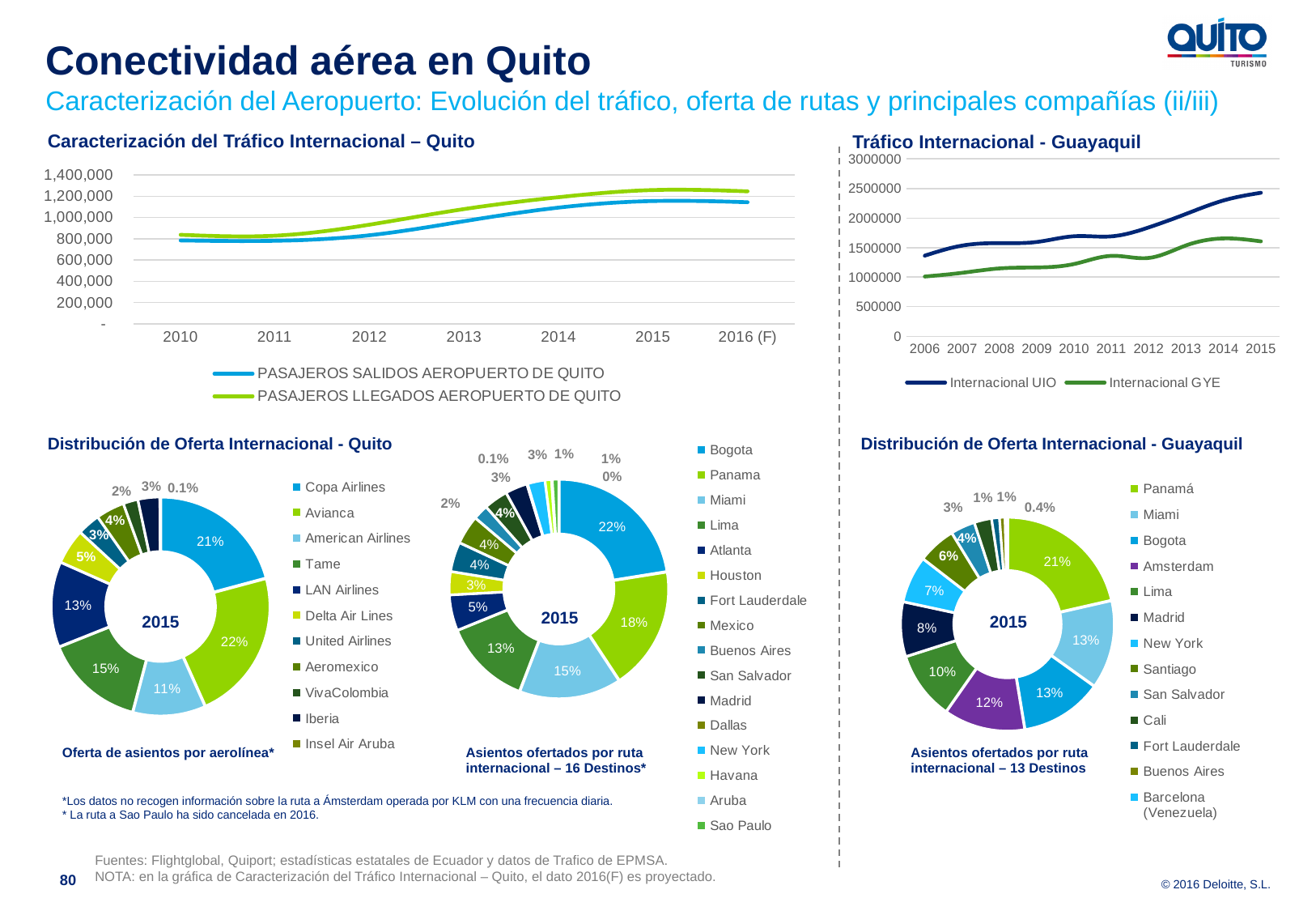
In the 'Distribución de Oferta Internacional - Guayaquil' donut chart, what share does Amsterdam have? 12% What kind of chart is the 'Caracterización del Tráfico Internacional – Quito' chart? line chart In the 'Caracterización del Tráfico Internacional – Quito' chart, is the value for PASAJEROS LLEGADOS AEROPUERTO DE QUITO in 2015 greater or less than 1,000,000? greater In the 'Oferta de asientos por aerolínea' donut chart, what is the difference between the shares of Tame and American Airlines? 4% In the 'Tráfico Internacional - Guayaquil' chart, is the value for Internacional GYE in 2006 greater or less than 1500000? less How many series does the legend of the 'Tráfico Internacional - Guayaquil' chart list? 2 In the 'Oferta de asientos por aerolínea' donut chart, what share does Avianca have? 22% In the 'Asientos ofertados por ruta internacional – 16 Destinos' donut chart, what share does Bogota have? 22% In the 'Oferta de asientos por aerolínea' donut chart, which airline has the largest share? Avianca In the 'Tráfico Internacional - Guayaquil' chart, does the Internacional UIO series rise or fall from 2006 to 2015? rises In the 'Distribución de Oferta Internacional - Guayaquil' donut chart, which has the larger share, Lima or Madrid? Lima How many destinations does the legend of the 'Asientos ofertados por ruta internacional – 16 Destinos' chart list? 16